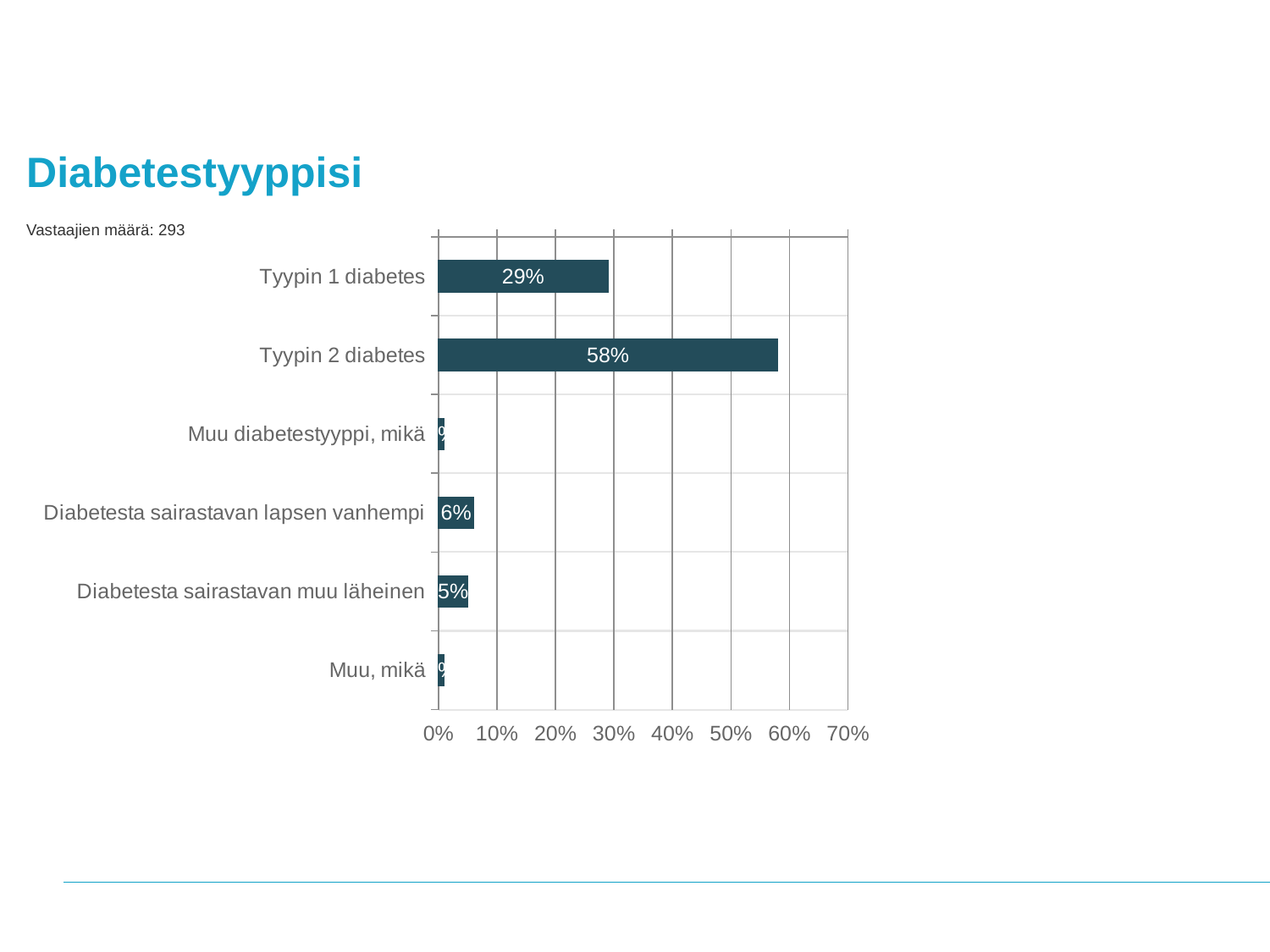
Which category has the highest value? Tyypin 2 diabetes Is the value for Muu diabetestyyppi, mikä greater or less than 10%? less How many categories are shown in the chart? 6 What kind of chart is shown on the slide? bar chart What is the value for Tyypin 2 diabetes? 58% What is the value for Tyypin 1 diabetes? 29% What is the difference between the values for Diabetesta sairastavan lapsen vanhempi and Diabetesta sairastavan muu läheinen? 1% Which is larger, the value for Tyypin 1 diabetes or the value for Tyypin 2 diabetes? Tyypin 2 diabetes What is the value for Diabetesta sairastavan lapsen vanhempi? 6% What is the difference between the values for Tyypin 2 diabetes and Tyypin 1 diabetes? 29% What is the value for Diabetesta sairastavan muu läheinen? 5% Is the value for Tyypin 2 diabetes greater or less than 50%? greater